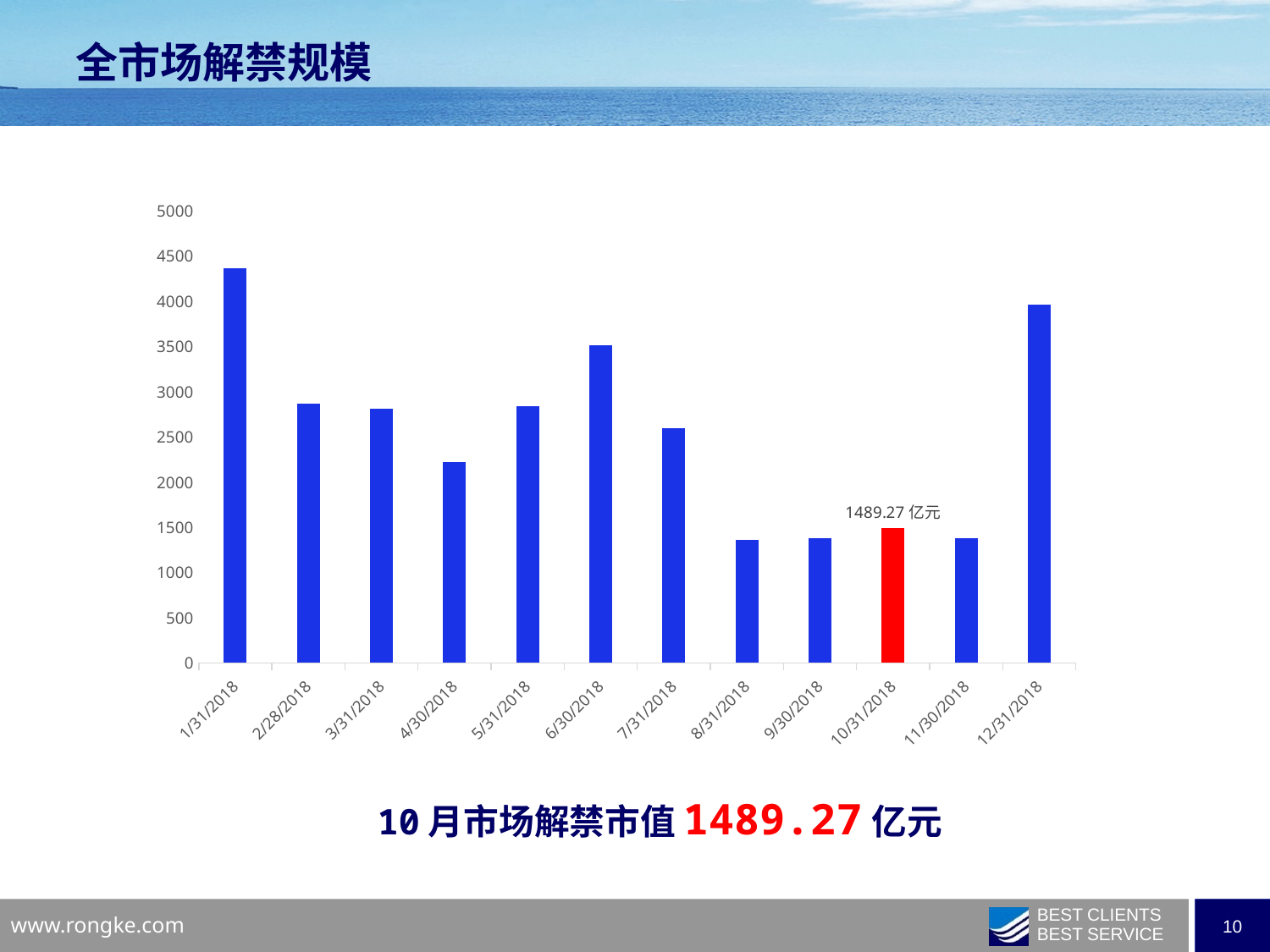
Which date has the highest bar? 1/31/2018 Which is larger, the value for 3/31/2018 or 4/30/2018? 3/31/2018 What kind of chart is shown on the slide? bar chart How many dates are shown on the x axis? 12 Is the value for 4/30/2018 greater or less than 2000? greater Which date's bar is coloured red? 10/31/2018 Is the value for 1/31/2018 greater or less than 4000? greater Is the value for 2/28/2018 greater or less than 3000? less Which is larger, the value for 6/30/2018 or 7/31/2018? 6/30/2018 What is the value shown for 10/31/2018? 1489.27 亿元